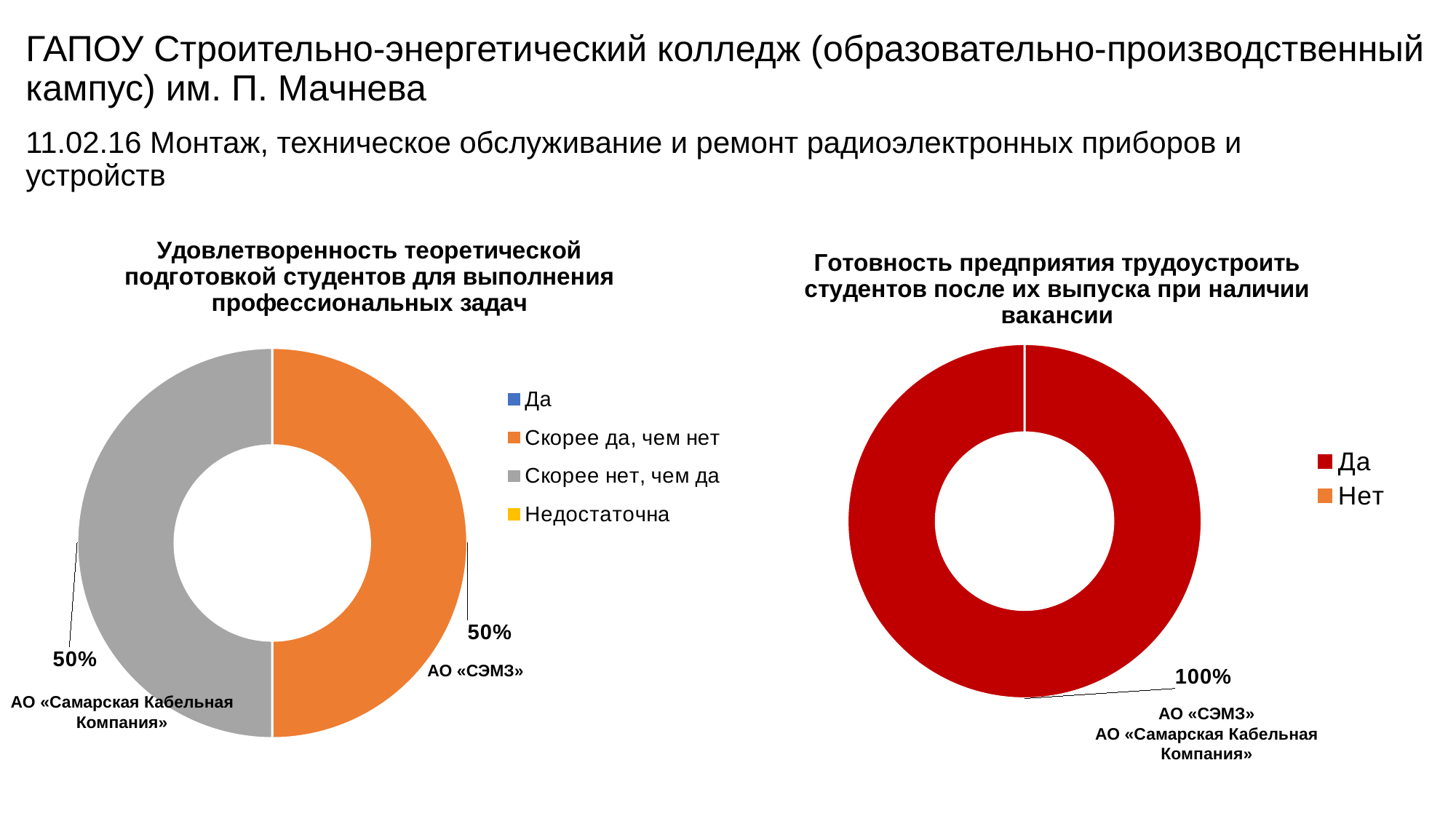
In the left chart (Удовлетворенность теоретической подготовкой студентов), which legend entry does the orange slice correspond to? Скорее да, чем нет What kind of chart is the left chart (Удовлетворенность теоретической подготовкой студентов)? Doughnut (pie) chart In the left chart (Удовлетворенность теоретической подготовкой студентов), what share is labelled for АО «Самарская Кабельная Компания»? 50% How many entries does the legend of the left chart (Удовлетворенность теоретической подготовкой студентов) list? 4 In the left chart (Удовлетворенность теоретической подготовкой студентов), what is the difference between the share for АО «СЭМЗ» and the share for АО «Самарская Кабельная Компания»? 0% In the left chart (Удовлетворенность теоретической подготовкой студентов), how many slices are visible in the doughnut? 2 In the left chart (Удовлетворенность теоретической подготовкой студентов), what share is labelled for АО «СЭМЗ»? 50% In the left chart (Удовлетворенность теоретической подготовкой студентов), which legend entry does the grey slice correspond to? Скорее нет, чем да What kind of chart is the right chart (Готовность предприятия трудоустроить студентов)? Doughnut (pie) chart How many entries does the legend of the right chart (Готовность предприятия трудоустроить студентов) list? 2 In the right chart (Готовность предприятия трудоустроить студентов), what percentage is shown for the «Да» slice? 100% In the right chart (Готовность предприятия трудоустроить студентов), which answer option makes up the whole chart? Да